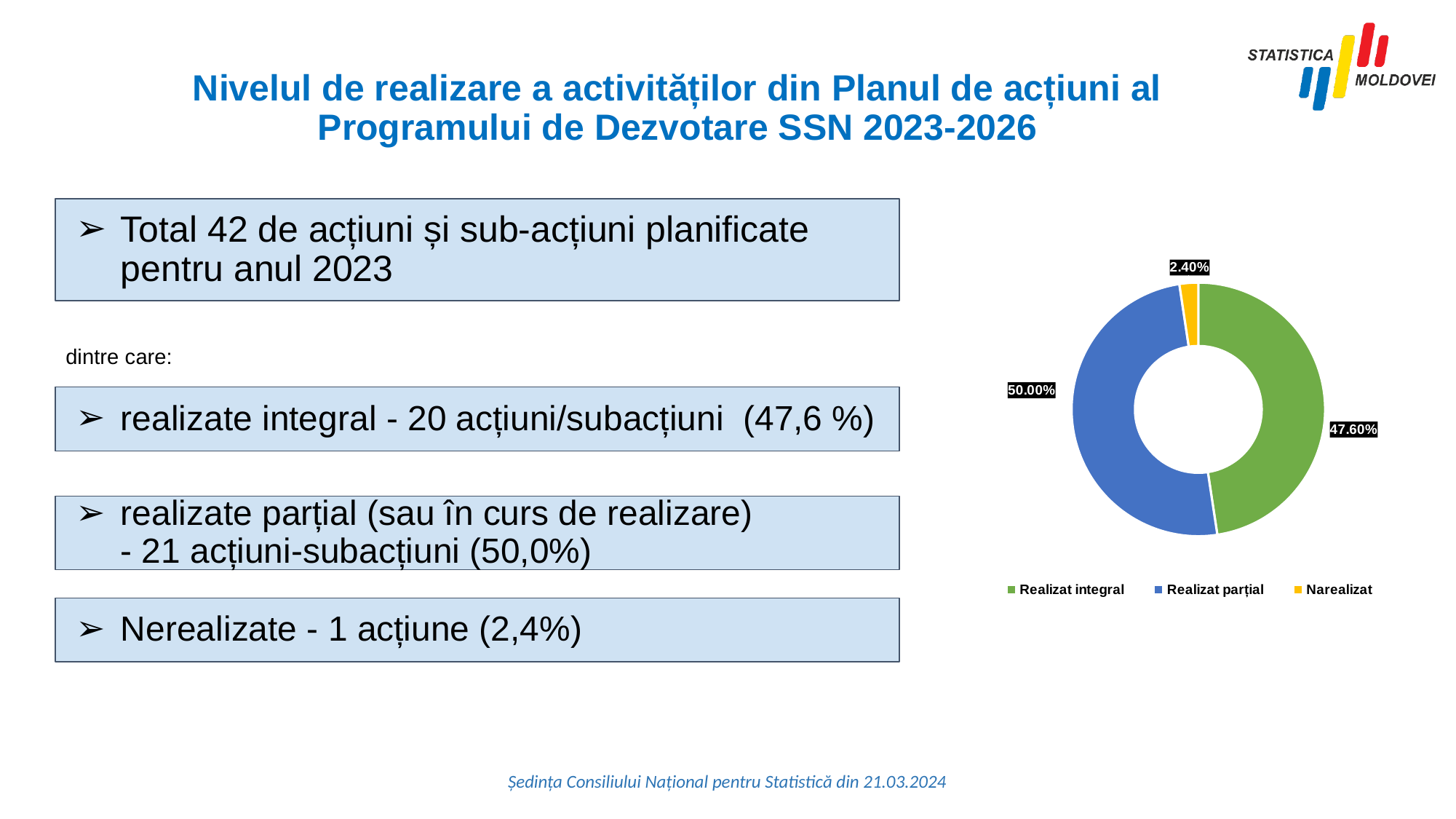
What colour is the Narealizat slice in the pie chart? Yellow What share of the pie chart does Narealizat represent? 2.40% What is the difference between the shares of Realizat integral and Narealizat? 45.20% What is the difference between the shares of Realizat parțial and Realizat integral? 2.40% How many categories are shown in the pie chart? 3 Which category has the largest share in the pie chart? Realizat parțial Which is larger, the share of Realizat integral or the share of Narealizat? Realizat integral What colour is the Realizat integral slice in the pie chart? Green What share of the pie chart does Realizat integral represent? 47.60% What kind of chart is shown on the slide? Doughnut chart Which category has the smallest share in the pie chart? Narealizat What share of the pie chart does Realizat parțial represent? 50.00%